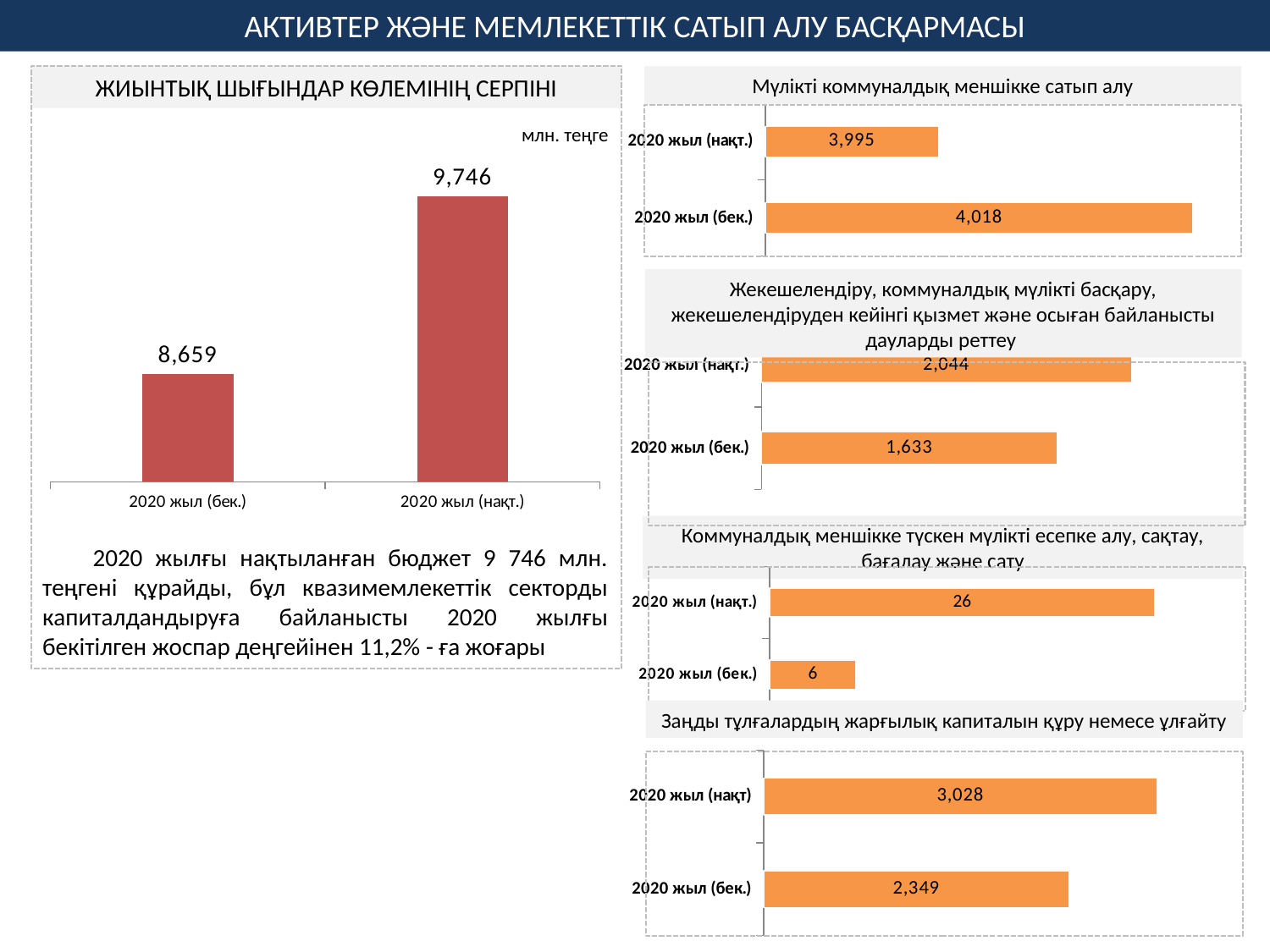
In the chart titled 'Коммуналдық меншікке түскен мүлікті есепке алу, сақтау, бағалау және сату', what is the difference between the 2020 жыл (нақт.) and 2020 жыл (бек.) values? 20 In the chart titled 'Жекешелендіру, коммуналдық мүлікті басқару, жекешелендіруден кейінгі қызмет және осыған байланысты дауларды реттеу', what is the value for 2020 жыл (бек.)? 1,633 In the chart titled 'Заңды тұлғалардың жарғылық капиталын құру немесе ұлғайту', which category has the lowest value? 2020 жыл (бек.) In the chart titled 'Заңды тұлғалардың жарғылық капиталын құру немесе ұлғайту', what is the value for 2020 жыл (нақт)? 3,028 In the chart titled 'ЖИЫНТЫҚ ШЫҒЫНДАР КӨЛЕМІНІҢ СЕРПІНІ', what is the value for 2020 жыл (нақт.)? 9,746 In the chart titled 'Мүлікті коммуналдық меншікке сатып алу', what is the value for 2020 жыл (бек.)? 4,018 In the chart titled 'ЖИЫНТЫҚ ШЫҒЫНДАР КӨЛЕМІНІҢ СЕРПІНІ', what is the value for 2020 жыл (бек.)? 8,659 In the chart titled 'ЖИЫНТЫҚ ШЫҒЫНДАР КӨЛЕМІНІҢ СЕРПІНІ', what is the difference between the 2020 жыл (нақт.) and 2020 жыл (бек.) values? 1,087 In the chart titled 'Коммуналдық меншікке түскен мүлікті есепке алу, сақтау, бағалау және сату', what is the value for 2020 жыл (нақт.)? 26 In the chart titled 'Мүлікті коммуналдық меншікке сатып алу', what is the value for 2020 жыл (нақт.)? 3,995 In the chart titled 'Жекешелендіру, коммуналдық мүлікті басқару, жекешелендіруден кейінгі қызмет және осыған байланысты дауларды реттеу', which category has the higher value, 2020 жыл (нақт.) or 2020 жыл (бек.)? 2020 жыл (нақт.) What kind of chart is the chart titled 'ЖИЫНТЫҚ ШЫҒЫНДАР КӨЛЕМІНІҢ СЕРПІНІ'? bar chart